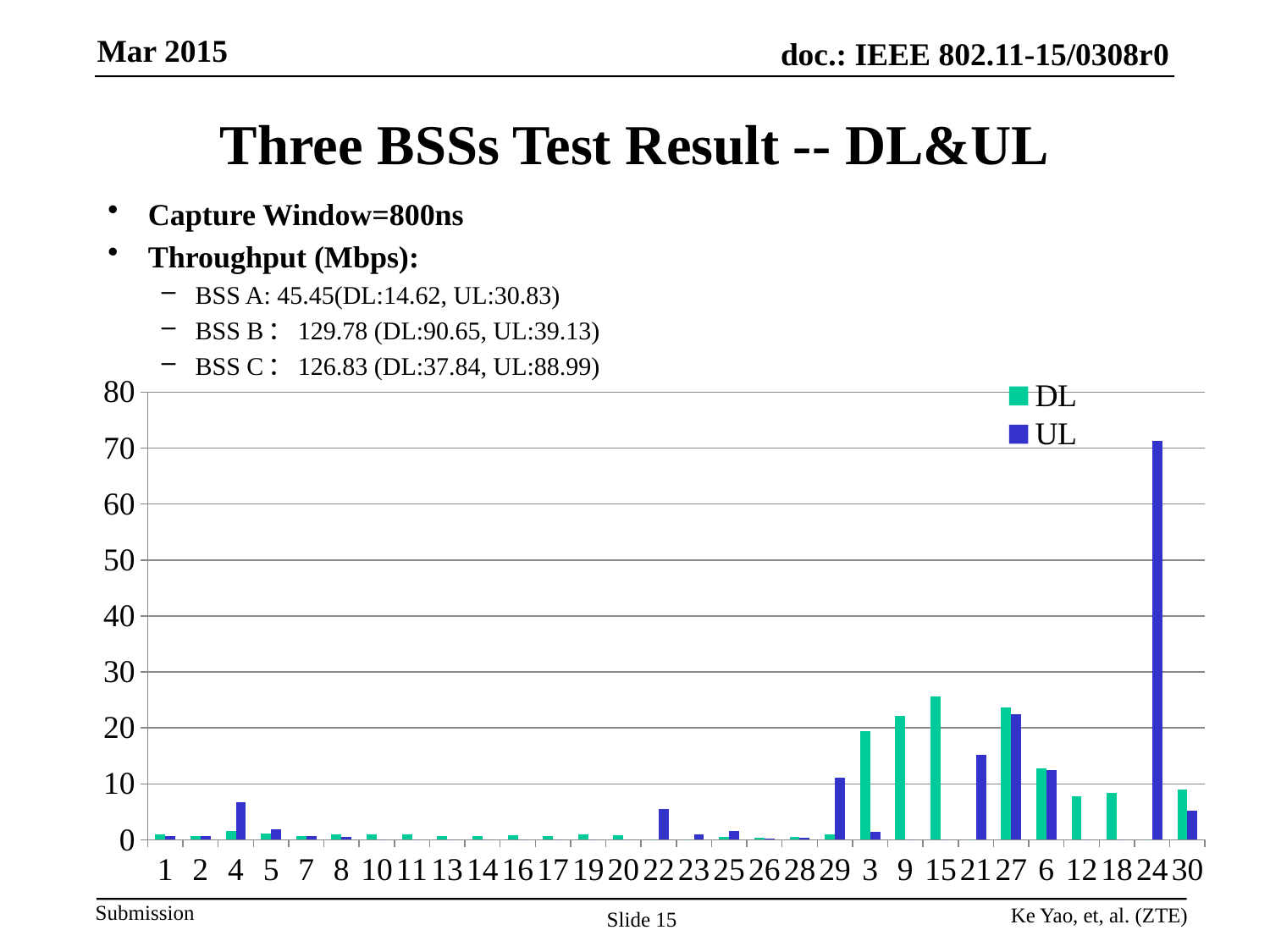
Is the UL value for category 24 greater or less than 60? greater Is the UL value for category 21 greater or less than 10? greater Which category has the highest DL value? 15 What are the two series named in the chart legend? DL and UL Is the DL value for category 12 greater or less than 10? less How many series does the chart legend list? 2 Which category has the highest UL value? 24 For category 24, which is larger, the DL value or the UL value? UL How many categories are shown along the x axis of the chart? 30 What kind of chart is shown on the slide? bar chart For category 30, which is larger, the DL value or the UL value? DL